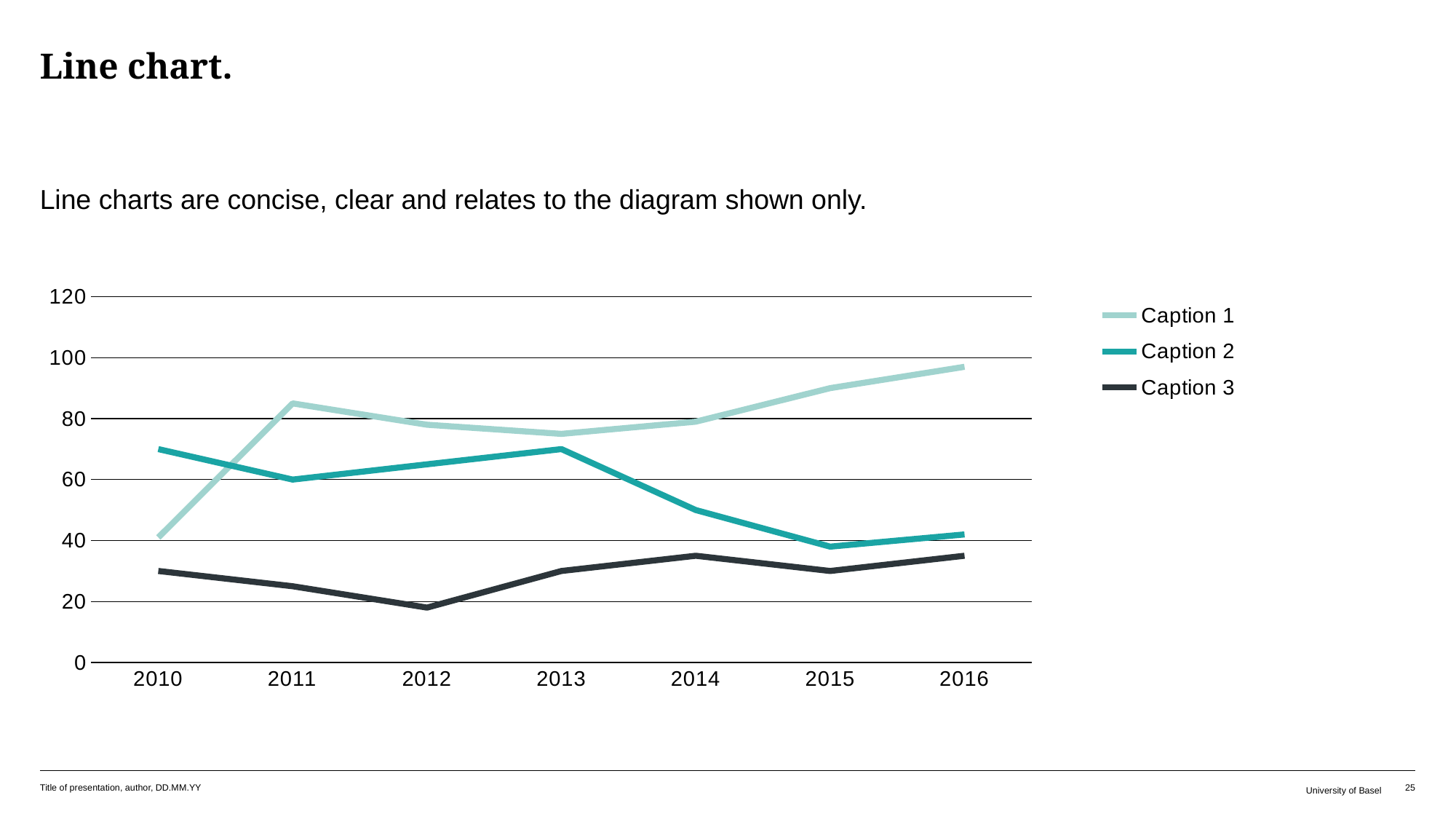
Which series has the highest value in 2016? Caption 1 Is the value for Caption 1 in 2016 greater or less than 80? greater Does Caption 2 rise or fall from 2013 to 2015? fall Does Caption 1 rise or fall from 2013 to 2016? rise How many series does the legend list? 3 In 2010, which is larger: Caption 1 or Caption 2? Caption 2 In 2014, which is larger: Caption 1 or Caption 2? Caption 1 Which series has the lowest value in 2012? Caption 3 What kind of chart is shown on the slide? line chart How many years are shown on the x axis? 7